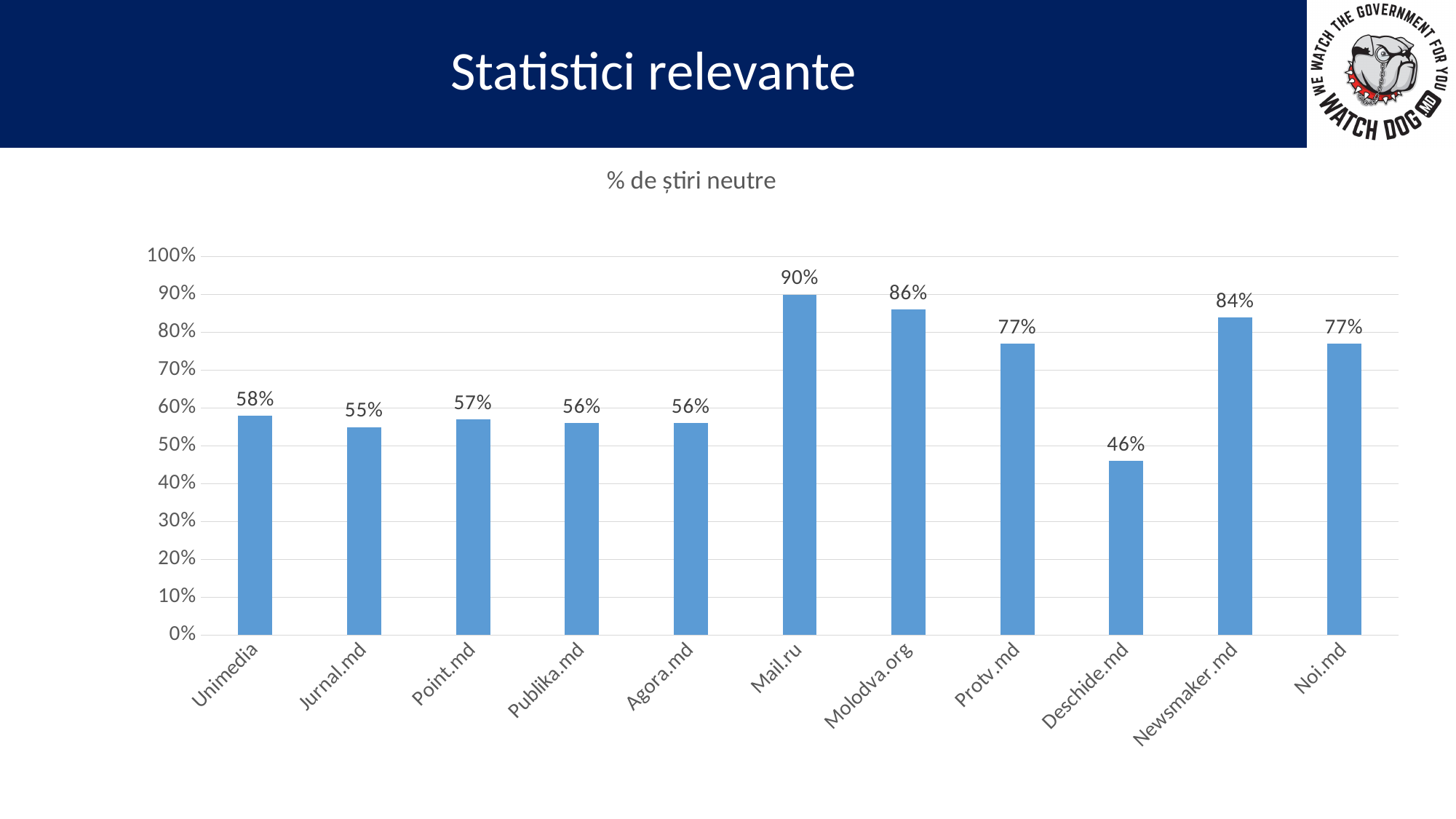
What kind of chart is shown on the slide? Bar chart What is the title of the chart? % de știri neutre Which category has the lowest value? Deschide.md What is the value for Deschide.md? 46% What is the value for Newsmaker.md? 84% Which category has the highest value? Mail.ru Which is larger, the value for Protv.md or the value for Point.md? Protv.md How many categories are shown on the x axis? 11 What is the difference between the values for Molodva.org and Unimedia? 28% What is the difference between the values for Mail.ru and Deschide.md? 44% What is the value for Mail.ru? 90% What is the value for Jurnal.md? 55%